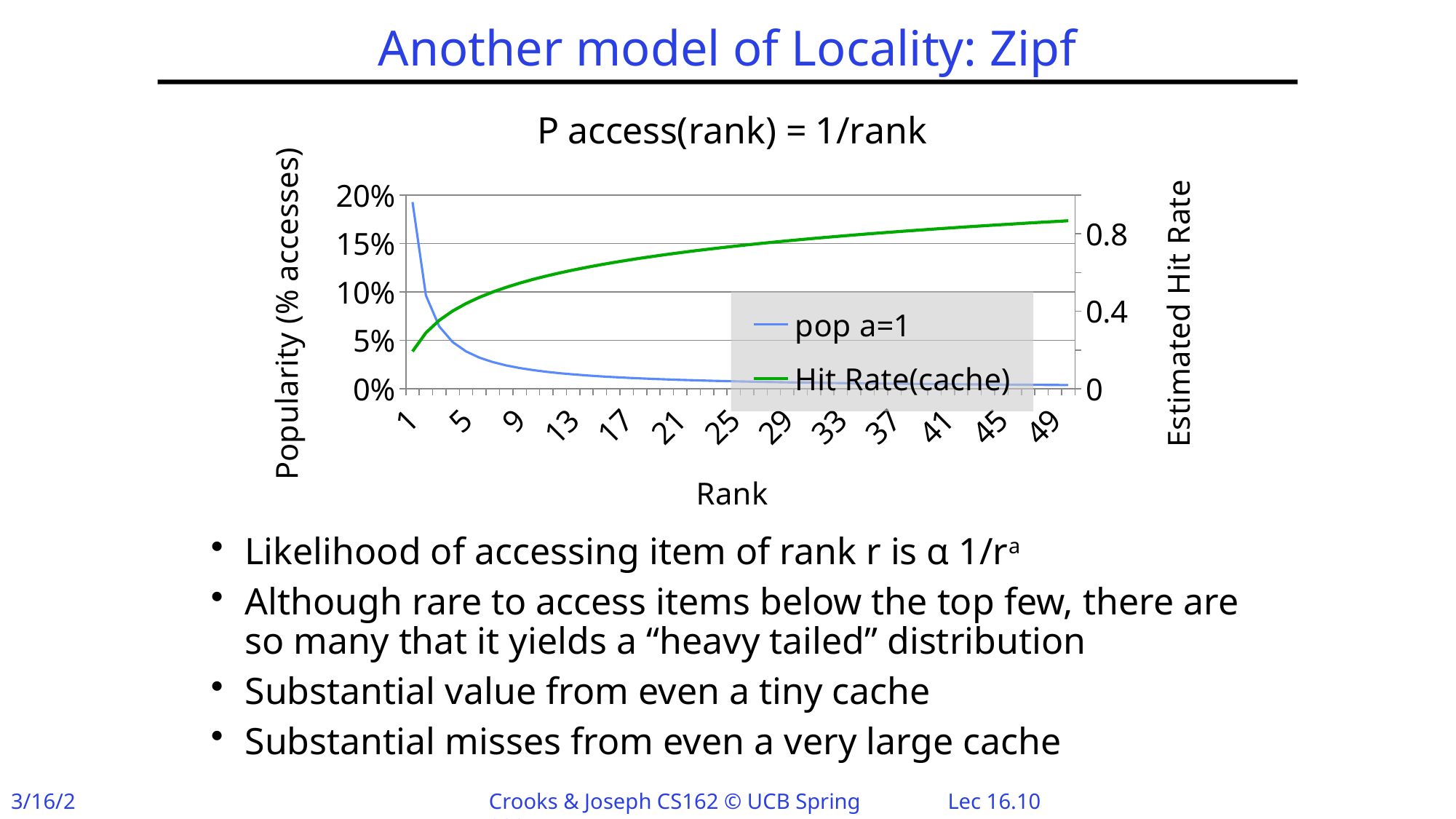
Does the 'Hit Rate(cache)' series rise or fall as rank increases? rise What is the label of the x axis? Rank Does the 'pop a=1' series rise or fall as rank increases? fall How many series does the legend list? 2 At rank 1, which series has the higher value relative to its own axis: 'pop a=1' or 'Hit Rate(cache)'? pop a=1 What kind of chart is shown on the slide? line chart Is the value of 'pop a=1' at rank 1 greater or less than 15%? greater What is the title of the chart? P access(rank) = 1/rank Is the value of 'Hit Rate(cache)' at rank 1 greater or less than 0.4? less Is the value of 'Hit Rate(cache)' at rank 49 greater or less than 0.8? greater